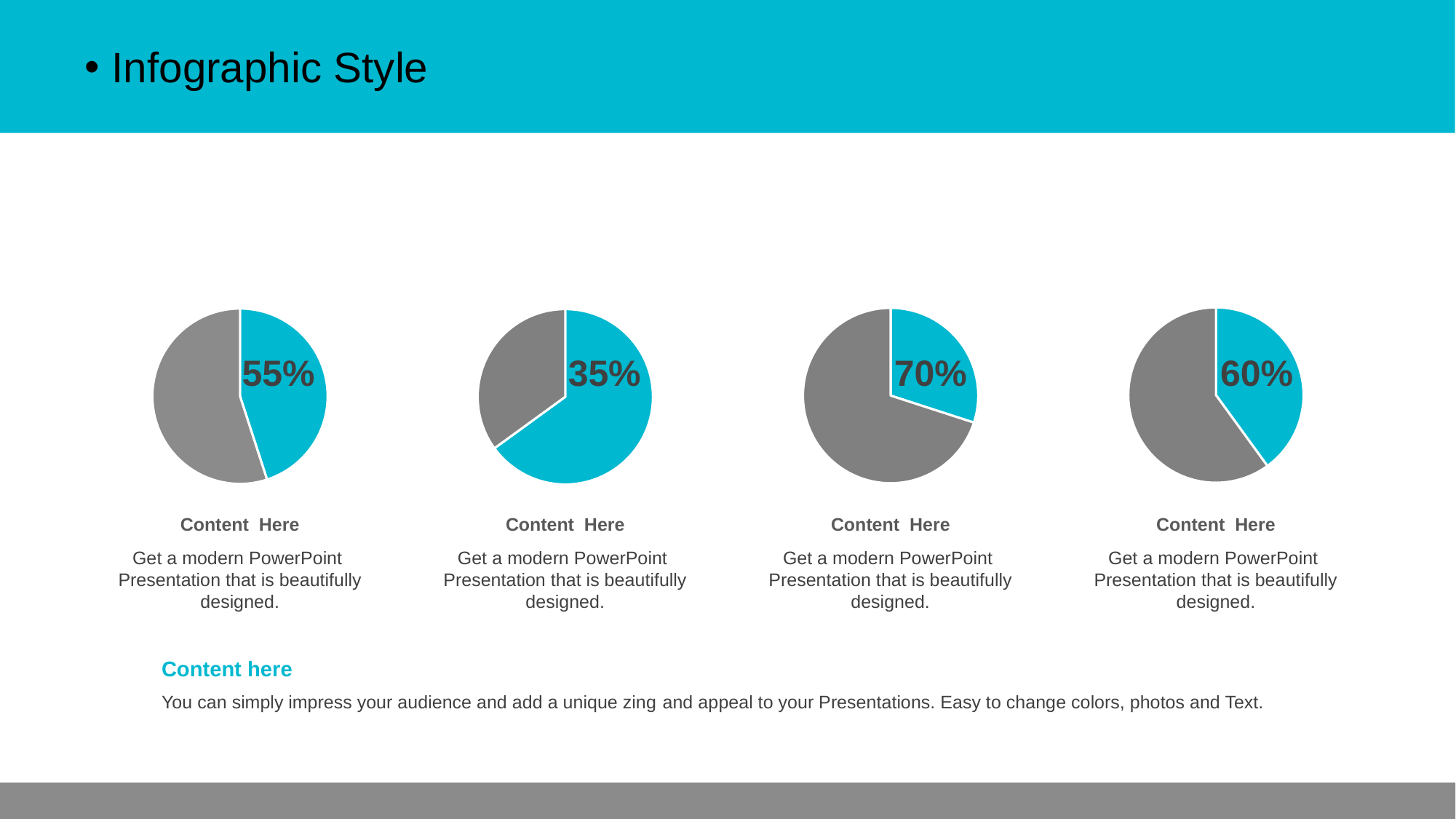
What percentage is printed on the rightmost pie chart? 60% Which pie chart shows the highest printed percentage? The third from the left (70%) Which has the larger printed percentage, the leftmost pie chart or the rightmost pie chart? The rightmost pie chart (60%) How many pie charts are on the slide? 4 What percentage is printed on the third pie chart from the left? 70% What two colours are used for the slices in the pie charts? Blue and gray What percentage is printed on the leftmost pie chart? 55% What is the difference between the percentage on the third pie chart and the percentage on the second pie chart? 35 percentage points What is the difference between the percentage on the rightmost pie chart and the percentage on the leftmost pie chart? 5 percentage points What kind of chart is shown in each of the four charts on the slide? Pie chart What percentage is printed on the second pie chart from the left? 35% Which pie chart shows the lowest printed percentage? The second from the left (35%)